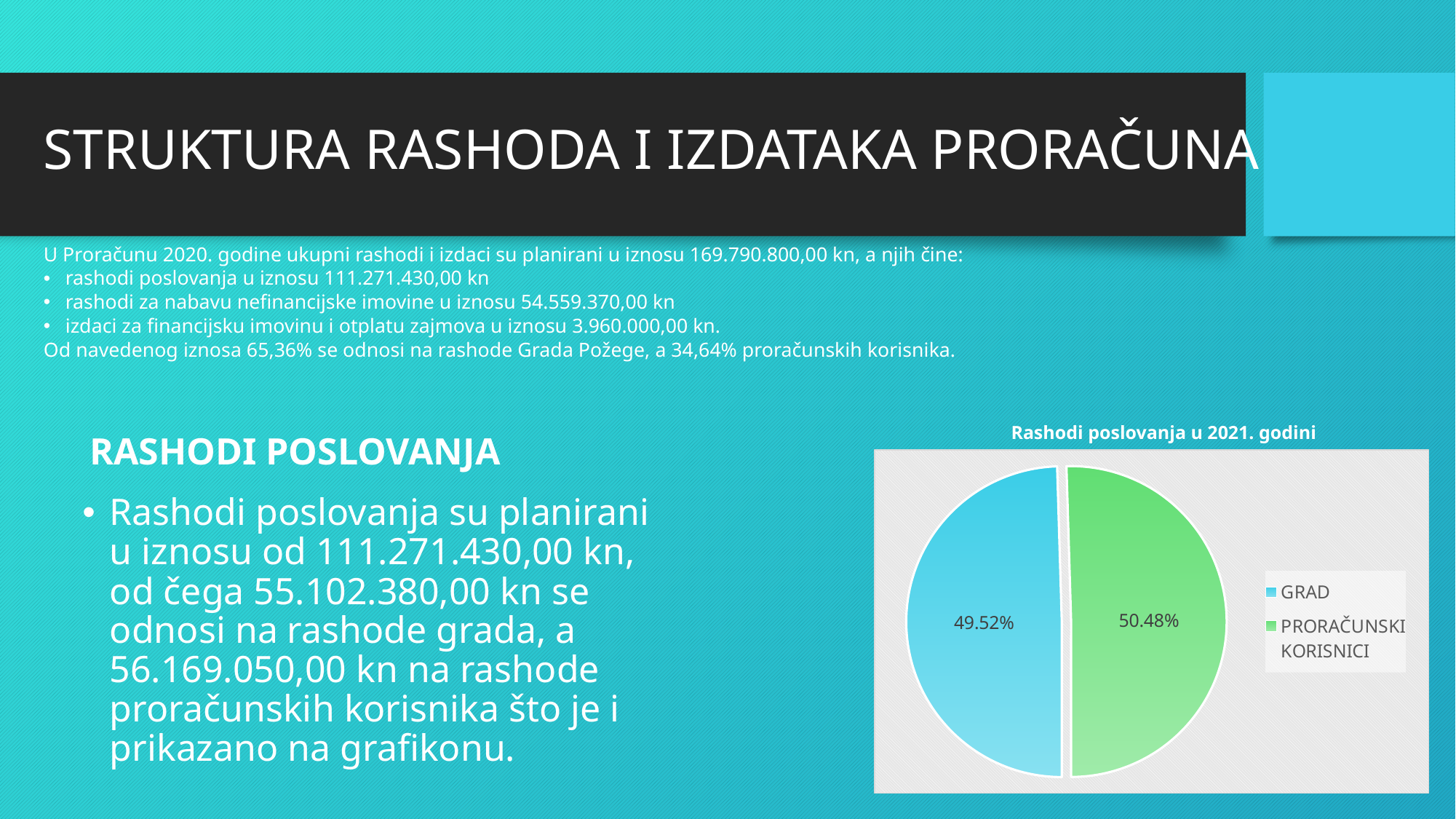
Which slice is the largest in the pie chart? PRORAČUNSKI KORISNICI What share of the pie does PRORAČUNSKI KORISNICI have? 50.48% Which is larger, the share for GRAD or the share for PRORAČUNSKI KORISNICI? PRORAČUNSKI KORISNICI Is the share for GRAD greater or less than 50%? less How many entries does the legend list? 2 What is the title of the chart? Rashodi poslovanja u 2021. godini Which slice is the smallest in the pie chart? GRAD How many slices does the pie chart have? 2 What is the difference between the share for PRORAČUNSKI KORISNICI and the share for GRAD? 0.96% What share of the pie does GRAD have? 49.52% What kind of chart is shown on the slide? pie chart What colour is the GRAD slice in the pie chart? blue